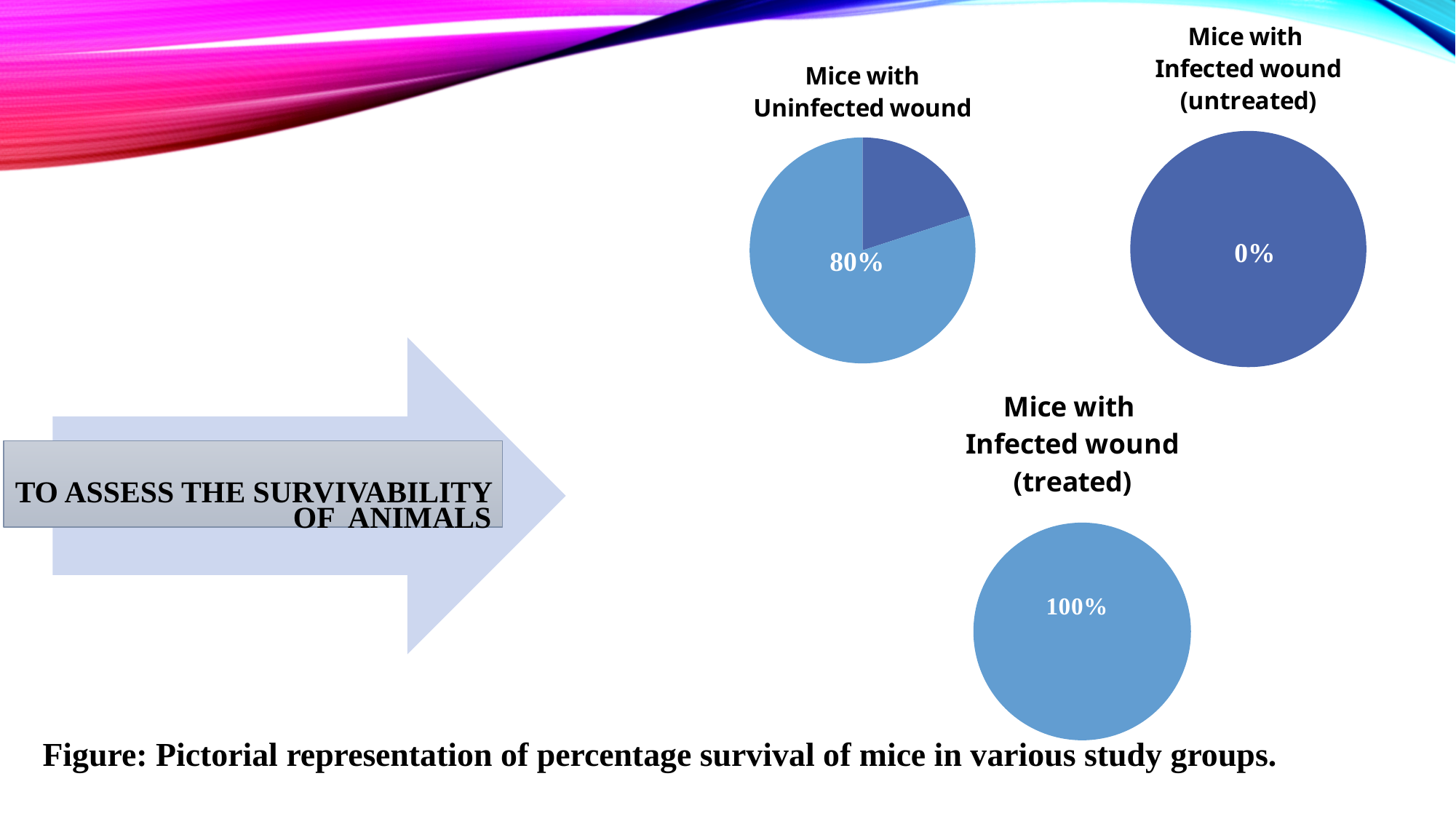
What does the figure caption at the bottom of the slide say the charts represent? Pictorial representation of percentage survival of mice in various study groups Which is larger: the survival percentage for 'Mice with Uninfected wound' or for 'Mice with Infected wound (treated)'? Mice with Infected wound (treated) In the 'Mice with Uninfected wound' chart, how many slices does the pie have? 2 What is the difference between the survival percentage for 'Mice with Infected wound (treated)' and 'Mice with Uninfected wound'? 20% Across the three charts, which study group shows the highest survival percentage? Mice with Infected wound (treated) In the 'Mice with Infected wound (untreated)' chart, what percentage is labelled on the pie? 0% How many pie charts are shown on the slide? 3 In the 'Mice with Uninfected wound' chart, what survival percentage is labelled on the pie? 80% Across the three charts, which study group shows the lowest survival percentage? Mice with Infected wound (untreated) What is the difference between the survival percentage for 'Mice with Uninfected wound' and 'Mice with Infected wound (untreated)'? 80% What kind of chart is used for each of the three study groups on the slide? Pie chart In the 'Mice with Infected wound (treated)' chart, what percentage is labelled on the pie? 100%